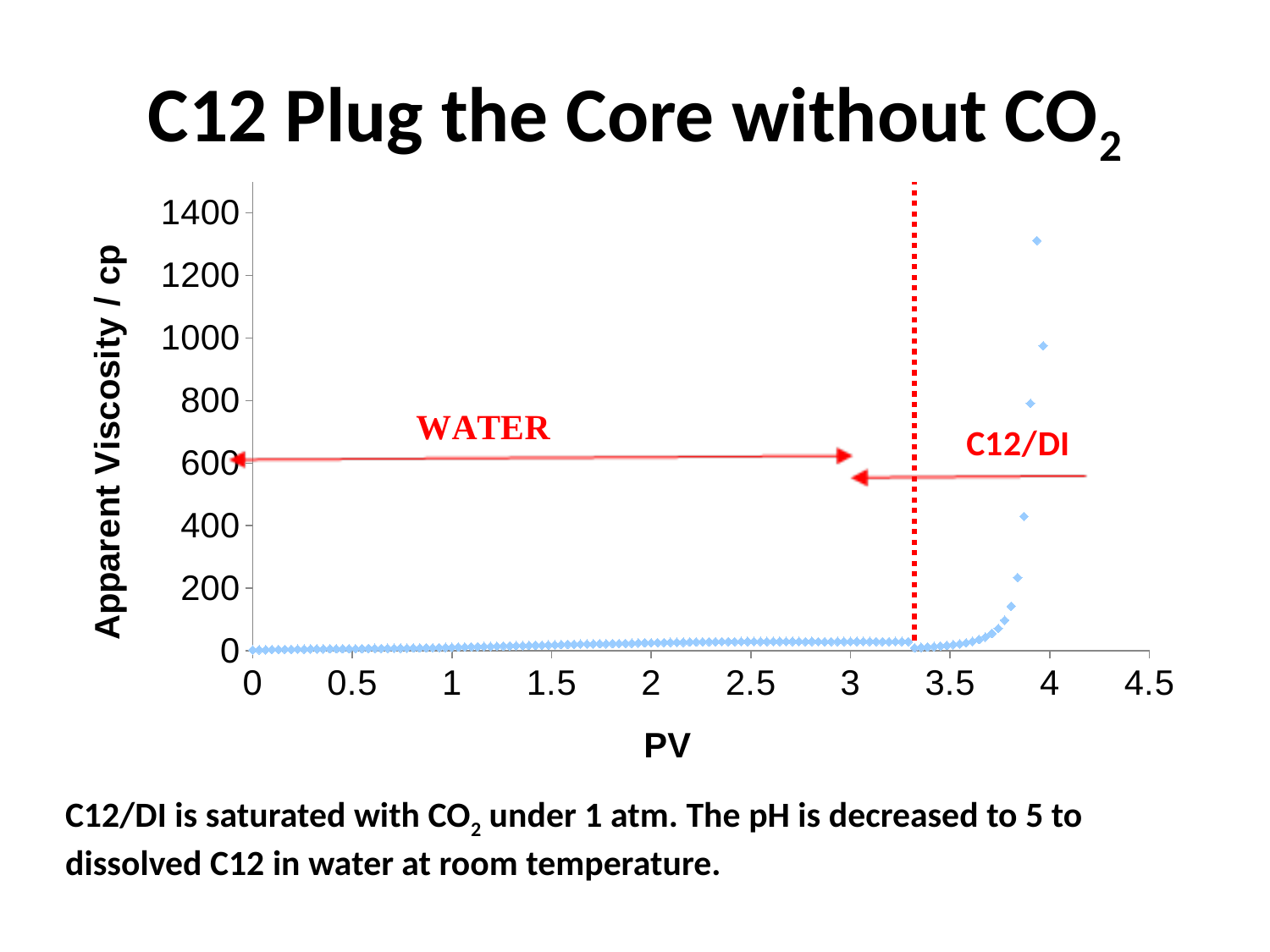
What is the highest tick value shown on the y axis? 1400 Is the apparent viscosity higher at PV = 1 or at PV = 3.9? PV = 3.9 Is the apparent viscosity at PV = 1 greater or less than 400? less Is the apparent viscosity at PV = 3 greater or less than 600? less What is the highest tick value shown on the x axis? 4.5 What kind of chart is shown on the slide? scatter chart Is the highest plotted apparent viscosity greater or less than 1200? greater What label is written above the long red arrow on the left side of the chart? WATER What is the title of the y axis? Apparent Viscosity / cp As PV increases beyond about 3.5, does the apparent viscosity rise or fall? rise